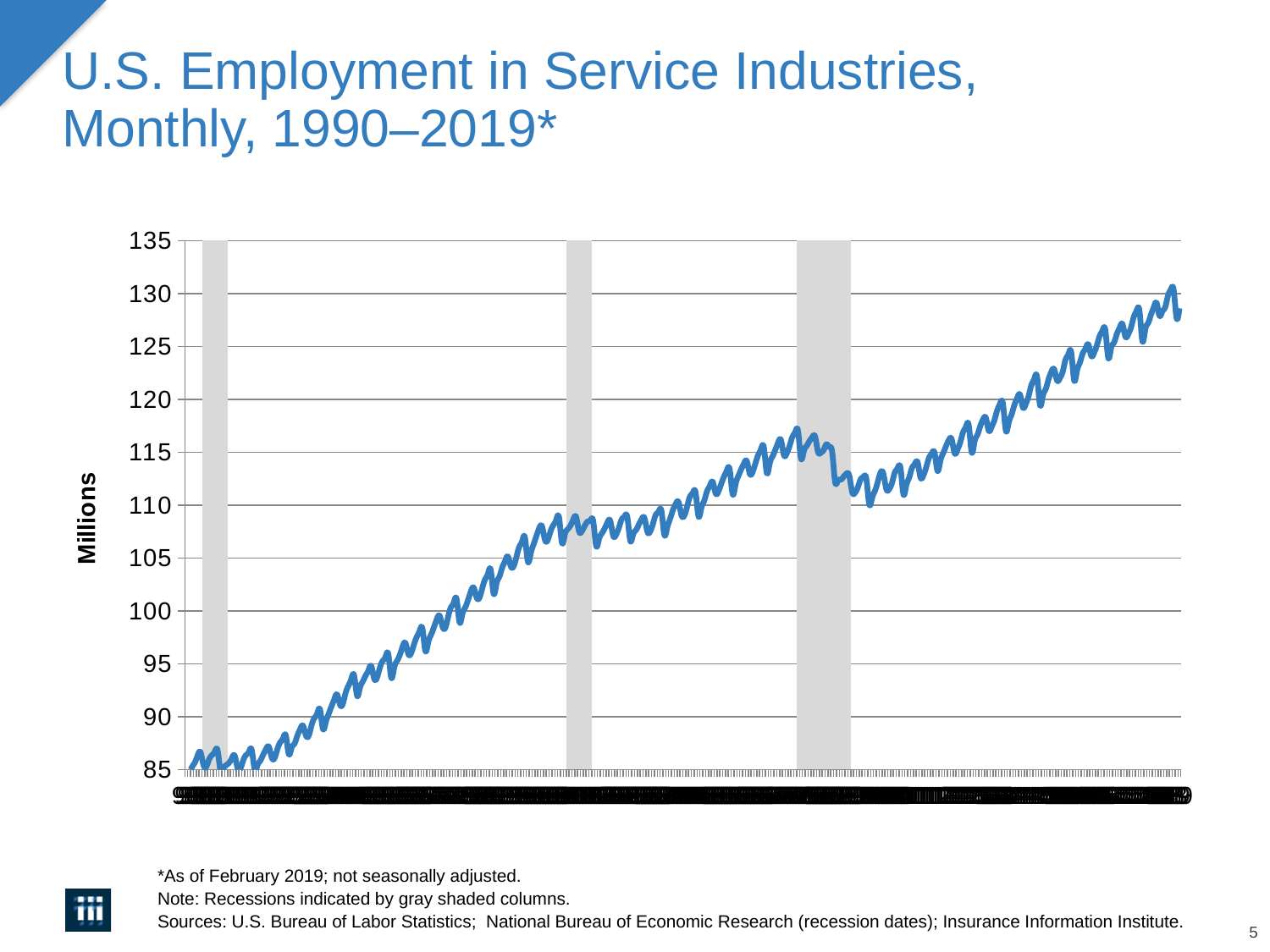
Is the value at the right end of the line (the most recent month) greater or less than 125? greater Is the value at the left end of the line (the earliest month) greater or less than 90? less Is the value at the right end of the line greater or less than the value at the left end of the line? greater Overall, does the line rise or fall from left to right across the chart? rise What unit label is shown on the vertical axis? Millions What is the highest value shown on the vertical axis? 135 What kind of chart is shown on the slide? line chart How many gray shaded recession columns appear on the chart? 3 What is the title of the chart? U.S. Employment in Service Industries, Monthly, 1990–2019*